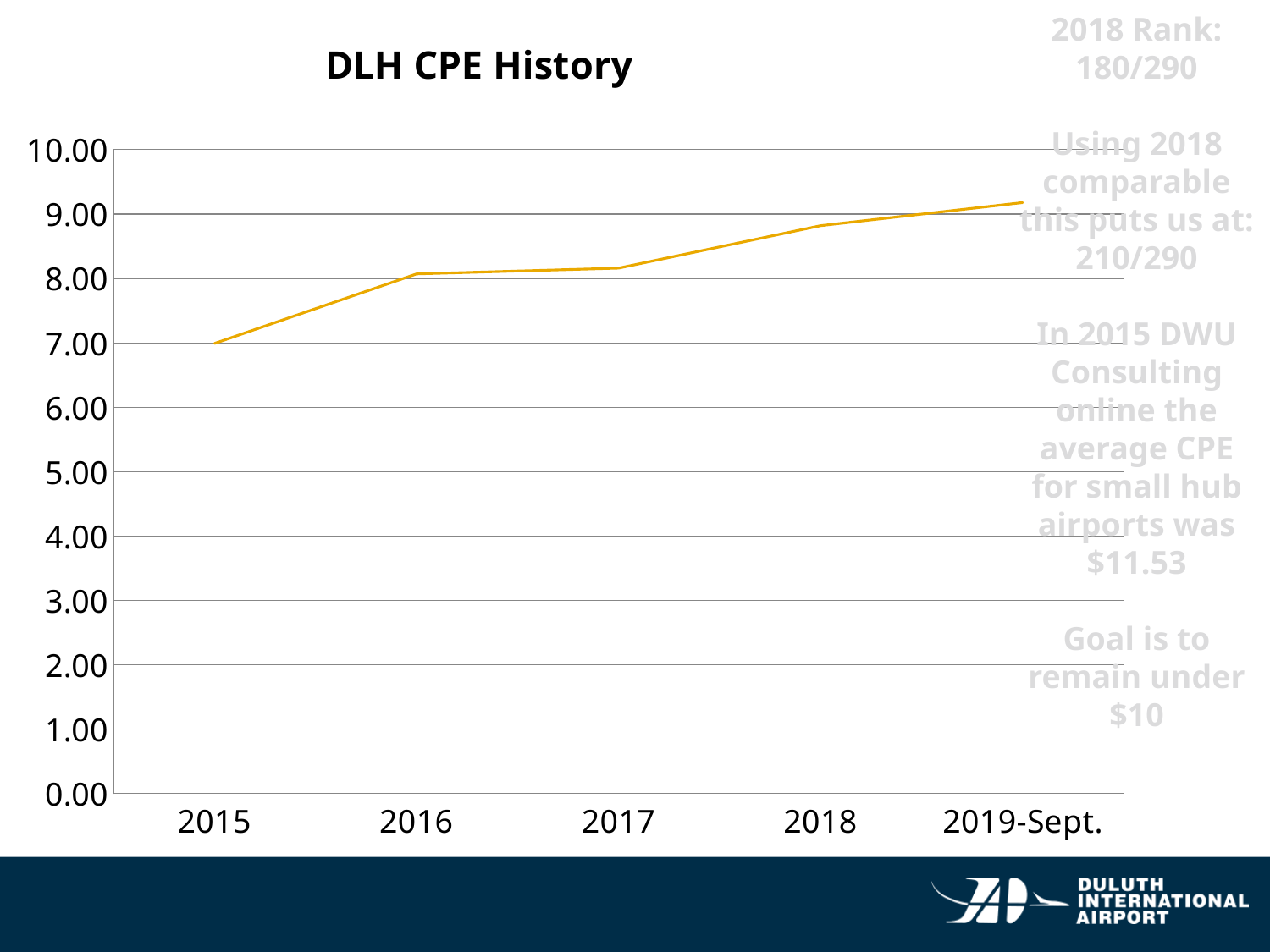
Which year has the highest value on the chart? 2019-Sept. What kind of chart is shown on the slide? line chart What is the title of the chart? DLH CPE History Is the value for 2018 greater or less than 9.00? less Is the value for 2018 greater or less than 8.00? greater What is the last category label on the x axis? 2019-Sept. Do the values rise or fall from 2015 to 2019-Sept.? rise Which is larger, the value for 2016 or the value for 2018? 2018 Is the value for 2015 greater or less than 8.00? less How many data points are plotted on the line? 5 Which year has the lowest value on the chart? 2015